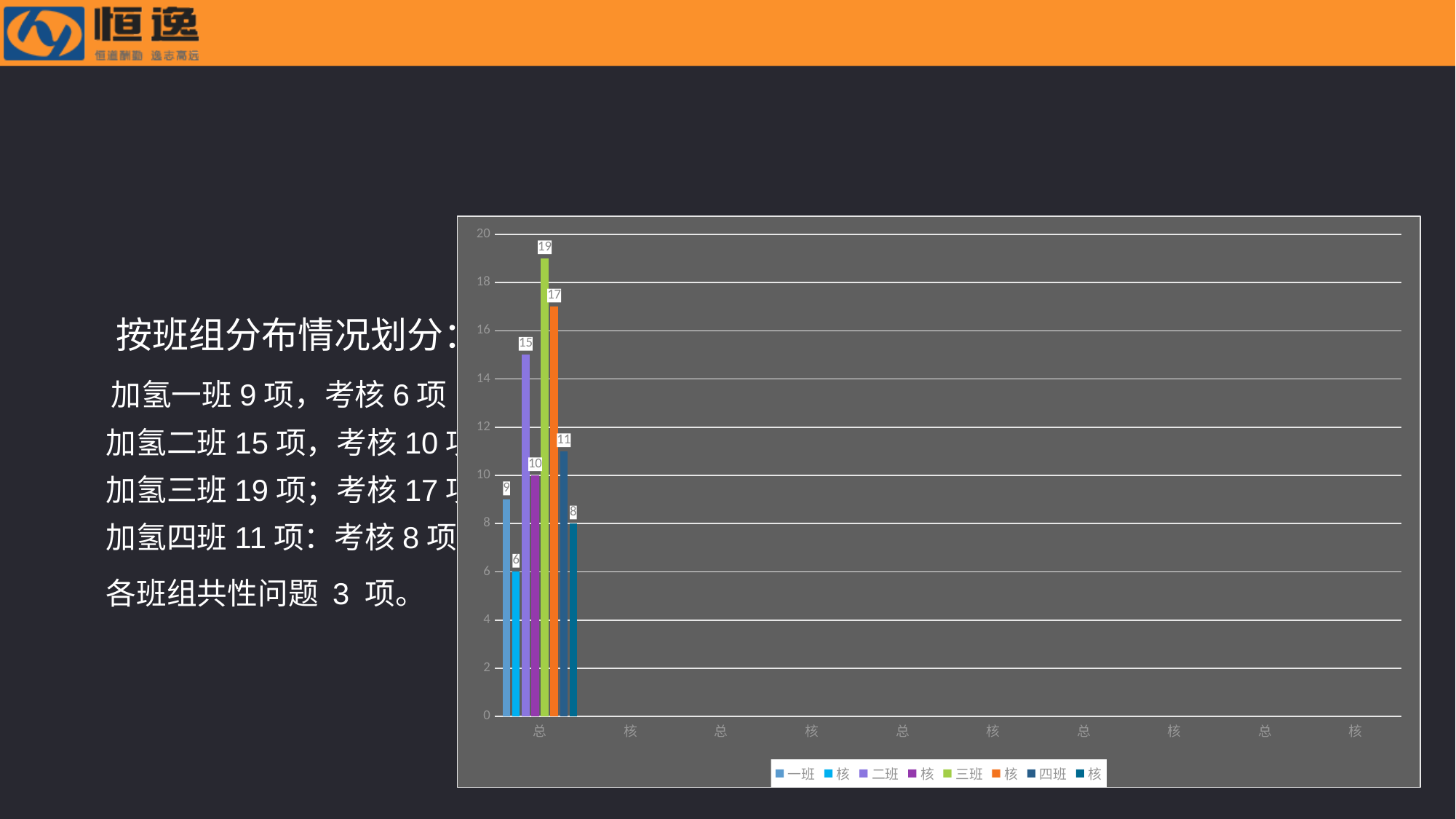
What is the value of the 四班 bar? 11 What is the value of the 二班 bar? 15 What is the smallest value labelled on any bar in the chart? 6 What is the value of the 三班 bar? 19 What is the difference between the 三班 bar and the 二班 bar? 4 Is the value of the 四班 bar greater or less than 10? greater Which series has the tallest bar in the chart? 三班 Which is larger, the 二班 bar or the 四班 bar? 二班 What is the difference between the 四班 bar and the 一班 bar? 2 How many series does the legend list? 8 What is the value of the 一班 bar? 9 What kind of chart is shown on the slide? bar chart